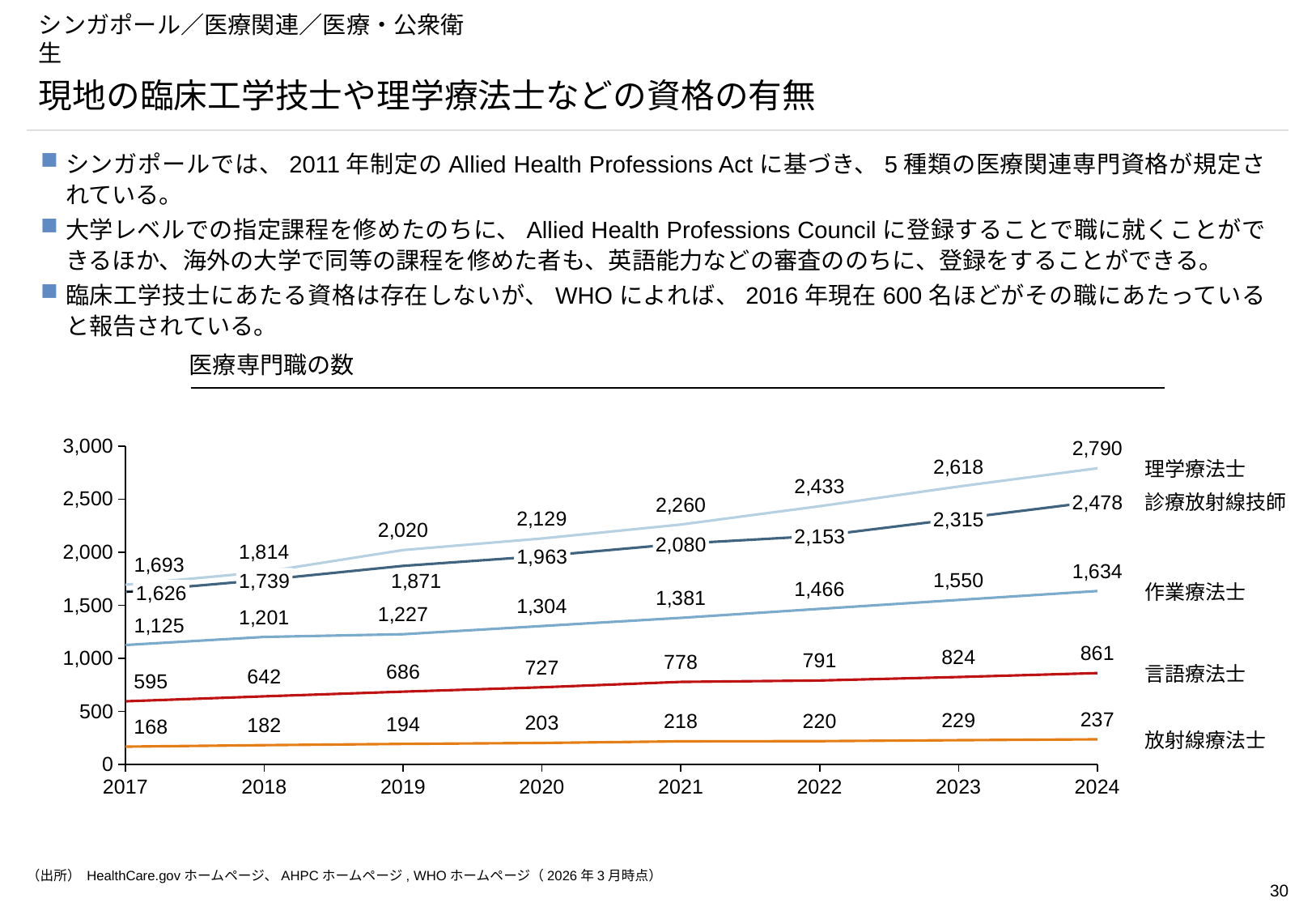
What is the difference between the 理学療法士 values in 2024 and 2017? 1,097 Does the value for 診療放射線技師 rise or fall from 2017 to 2024? rise What is the value for 理学療法士 in 2024? 2,790 Which is larger in 2022: the value for 作業療法士 or the value for 言語療法士? 作業療法士 What is the value for 言語療法士 in 2020? 727 What is the value for 診療放射線技師 in 2017? 1,626 What type of chart is shown on the slide? line chart Which series has the lowest value in 2017? 放射線療法士 What is the value for 作業療法士 in 2021? 1,381 How many years are plotted on the x axis? 8 Which series has the highest value in 2024? 理学療法士 What is the value for 放射線療法士 in 2023? 229